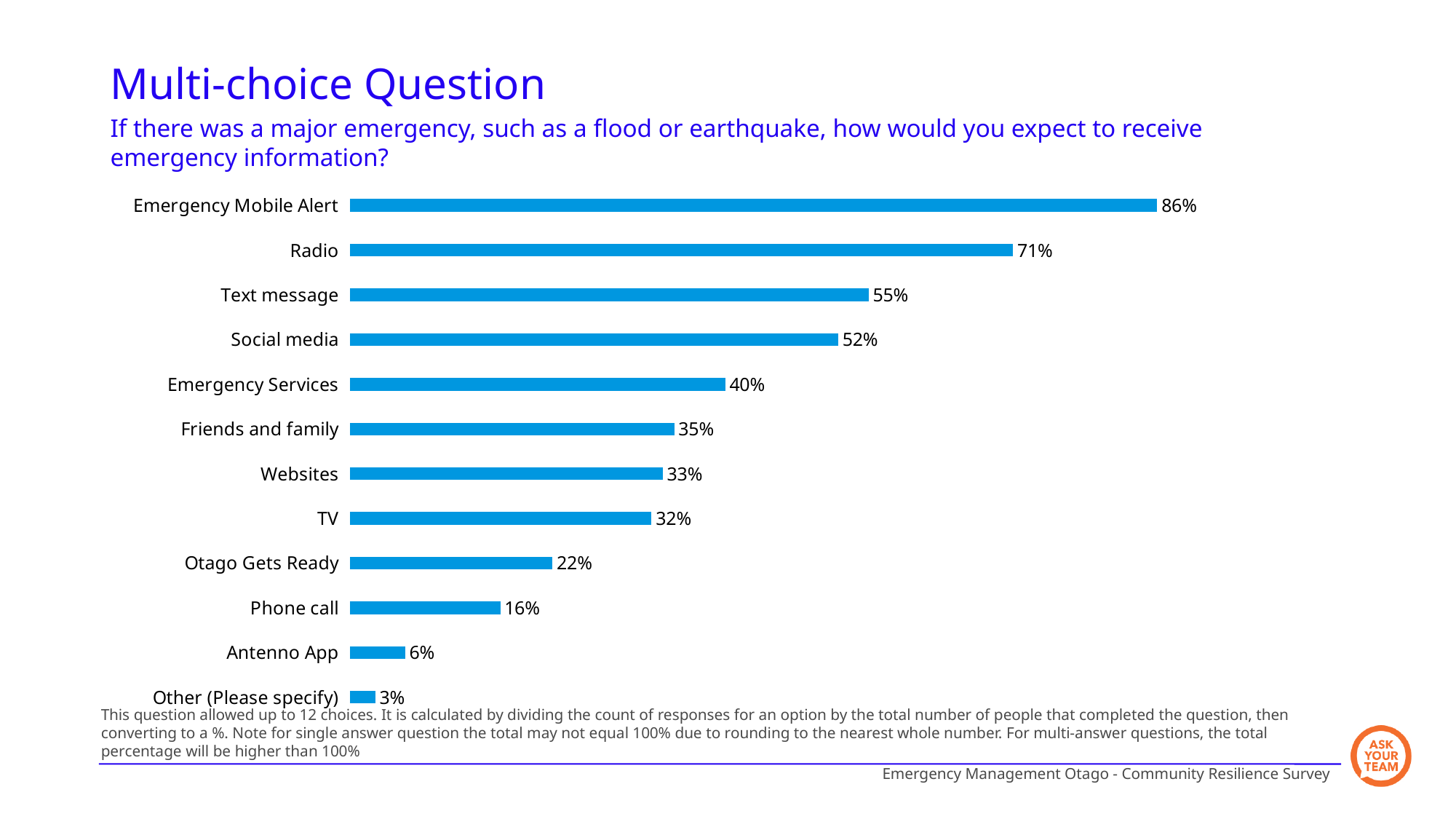
Which has a higher value, Emergency Services or Friends and family? Emergency Services Which category has the lowest value in the chart? Other (Please specify) What is the difference between the values for Emergency Mobile Alert and Radio? 15% Which has a higher value, Phone call or Antenno App? Phone call Which category has the highest value in the chart? Emergency Mobile Alert What colour are the bars in the chart? Blue What percentage of respondents expect to receive emergency information via Emergency Mobile Alert? 86% What is the difference between the values for Text message and Social media? 3% What is the value shown for Radio? 71% How many categories are shown in the chart? 12 What percentage is shown for Otago Gets Ready? 22% What type of chart is shown on the slide? Bar chart